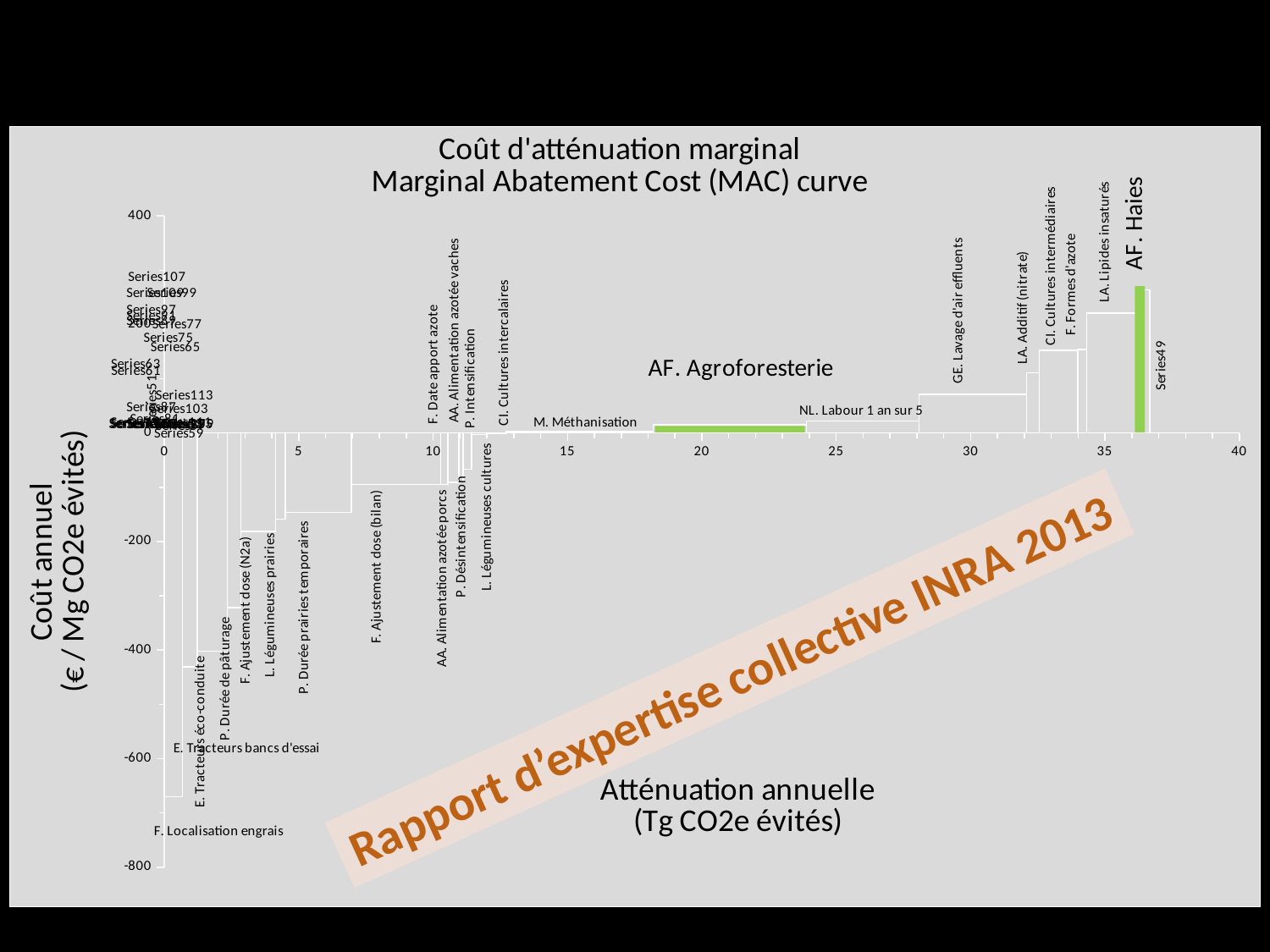
Do the annual cost values generally rise or fall as you move from left to right along the x axis? rise Is the annual cost for P. Durée de pâturage greater or less than -400? greater What is the label of the vertical axis? Coût annuel (€ / Mg CO2e évités) Is the annual cost for GE. Lavage d'air effluents greater or less than 200? less Is the annual cost for F. Localisation engrais greater or less than -600? less Which has the higher annual cost, AF. Haies or GE. Lavage d'air effluents? AF. Haies What is the title of the chart? Coût d'atténuation marginal / Marginal Abatement Cost (MAC) curve Which measure has the highest annual cost on the chart? AF. Haies Which has the lower annual cost, F. Localisation engrais or E. Tracteurs bancs d'essai? F. Localisation engrais Which measure has the lowest (most negative) annual cost on the chart? F. Localisation engrais